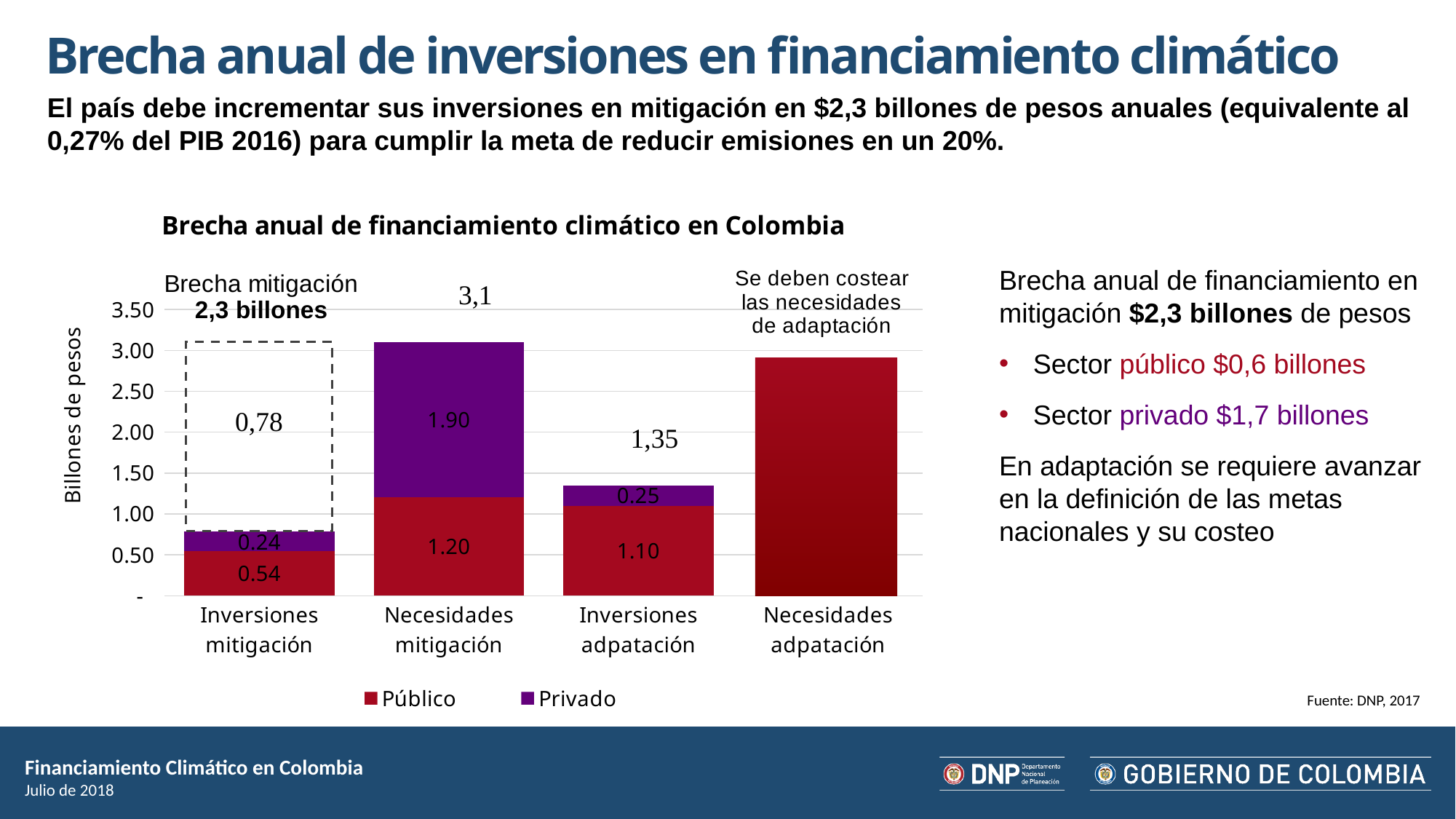
What is the Público value for Inversiones mitigación? 0.54 Is the value of the Necesidades adpatación bar greater or less than 2.50? greater What total is printed above the Inversiones adpatación bar? 1,35 Which category has the tallest stacked bar? Necesidades mitigación What is the difference between the Público values for Necesidades mitigación and Inversiones mitigación? 0.66 What total is printed above the Necesidades mitigación bar? 3,1 What is the Privado value for Necesidades mitigación? 1.90 Which is larger: the Privado value for Necesidades mitigación or the Privado value for Inversiones adpatación? Necesidades mitigación How many series does the legend list? 2 What is the Público value for Inversiones adpatación? 1.10 Which category has the shortest stacked bar? Inversiones mitigación How many categories are shown on the x axis? 4